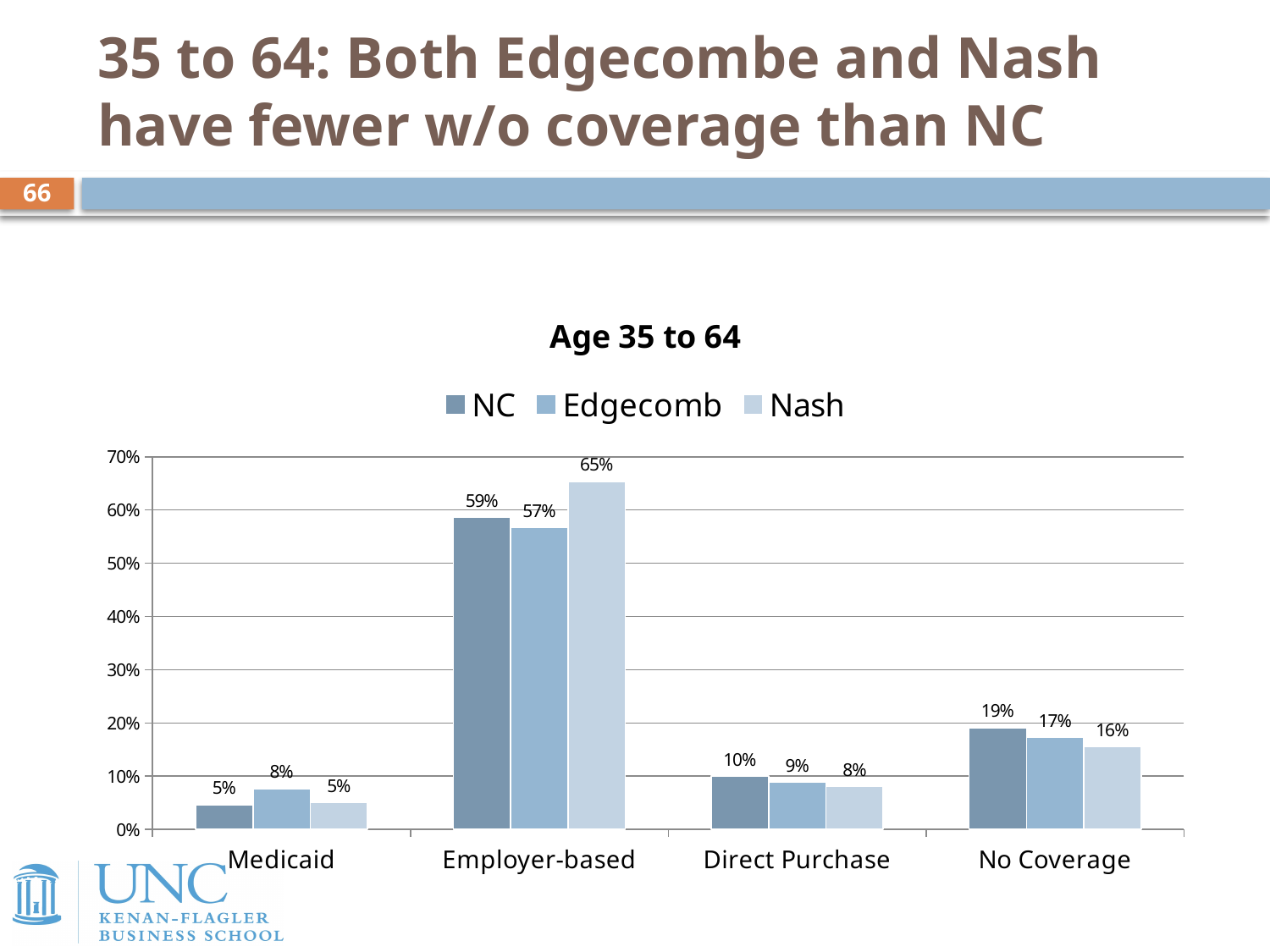
How many series does the legend list? 3 Which category has the highest value for NC? Employer-based What kind of chart is shown on the slide? bar chart What is the value for NC in the No Coverage category? 19% What is the value for Edgecomb in the Medicaid category? 8% What is the title of the chart? Age 35 to 64 What is the difference between the NC and Nash values in the No Coverage category? 3% Which series has the lowest value in the No Coverage category? Nash Which is larger in the Employer-based category, the value for NC or the value for Edgecomb? NC What is the value for Nash in the Employer-based category? 65% Is the value for Nash in the Employer-based category greater or less than 60%? greater How many categories are shown on the x axis? 4